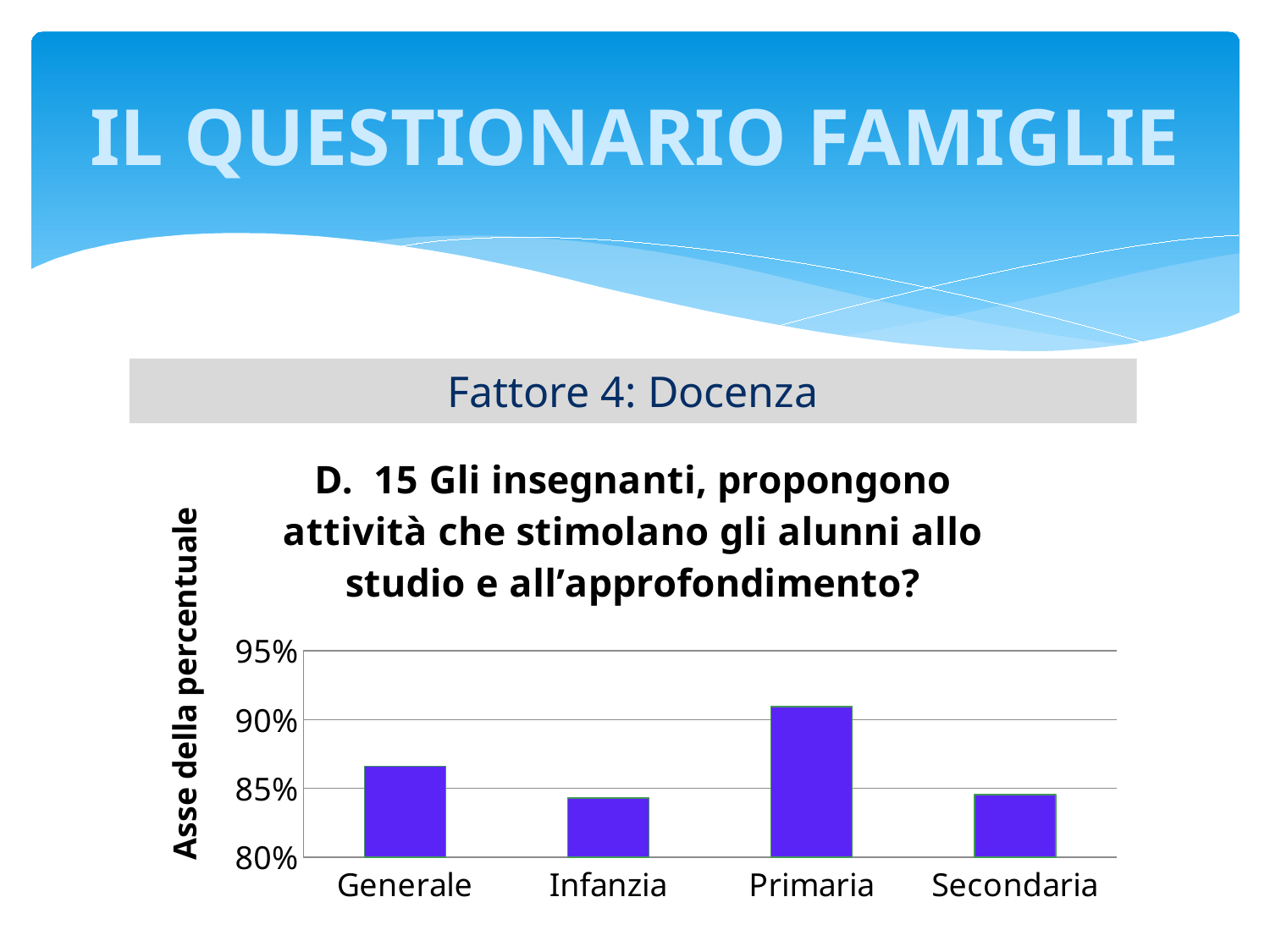
Which is larger, the value for Generale or the value for Infanzia? Generale Which is larger, the value for Primaria or the value for Generale? Primaria Is the value for Infanzia greater or less than 85%? less Is the value for Primaria greater or less than 90%? greater Which category has the highest value in the chart? Primaria What is the label of the vertical axis of the chart? Asse della percentuale Is the value for Generale greater or less than 85%? greater What is the lowest value shown on the vertical axis of the chart? 80% What kind of chart is shown on the slide? bar chart How many categories are shown on the x axis of the chart? 4 Which is larger, the value for Generale or the value for Secondaria? Generale